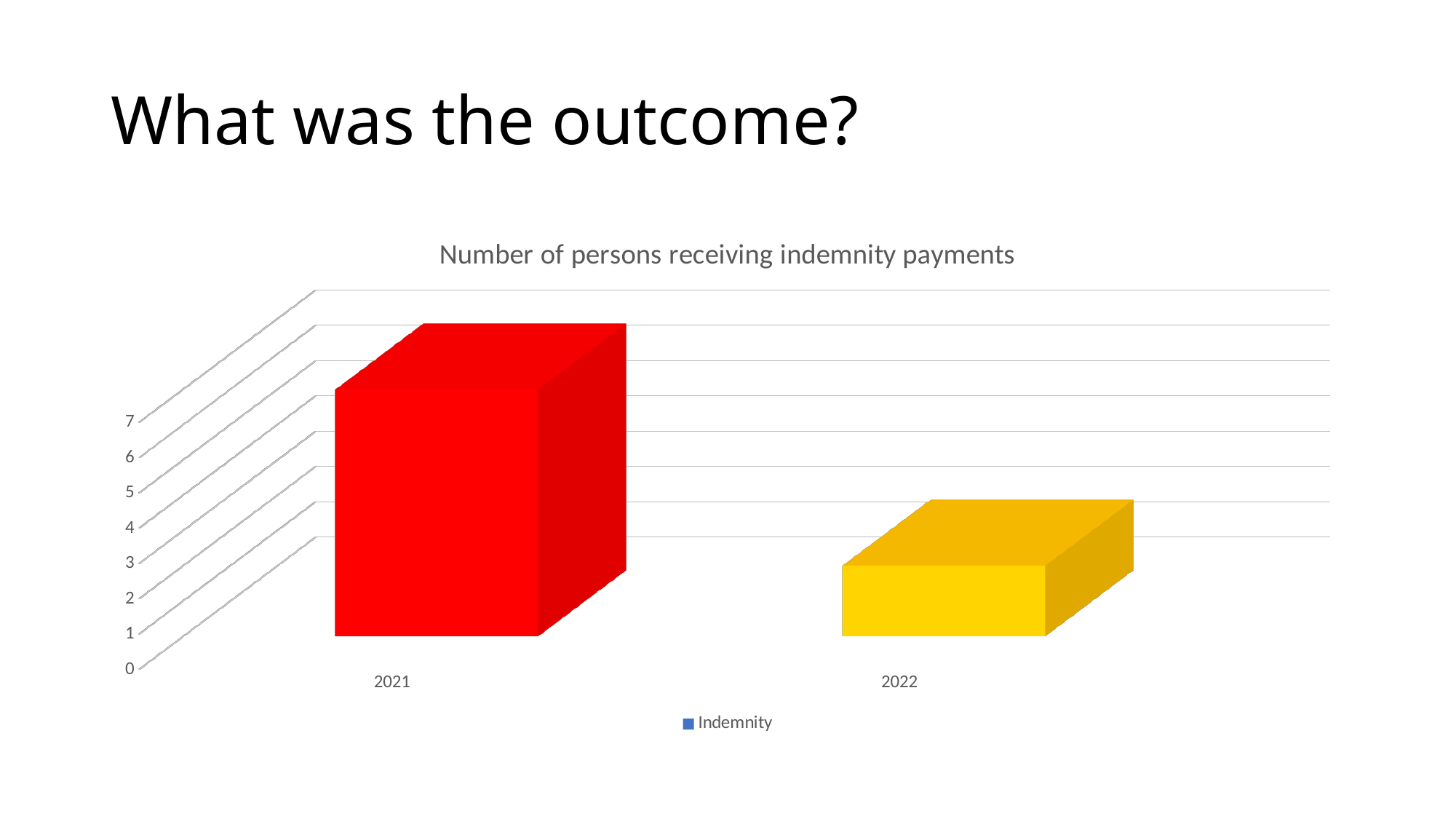
What is the title of the chart? Number of persons receiving indemnity payments How many series does the chart legend list? 1 Which is larger, the value for 2021 or the value for 2022? 2021 Do the values rise or fall from 2021 to 2022? fall How many categories are shown on the x axis of the chart? 2 What series name is shown in the chart legend? Indemnity Which year has the highest number of persons receiving indemnity payments? 2021 Which year has the lowest number of persons receiving indemnity payments? 2022 What kind of chart is shown on the slide? bar chart Is the value for 2022 greater or less than 4? less Is the value for 2021 greater or less than 5? greater Is the value for 2022 greater or less than 1? greater